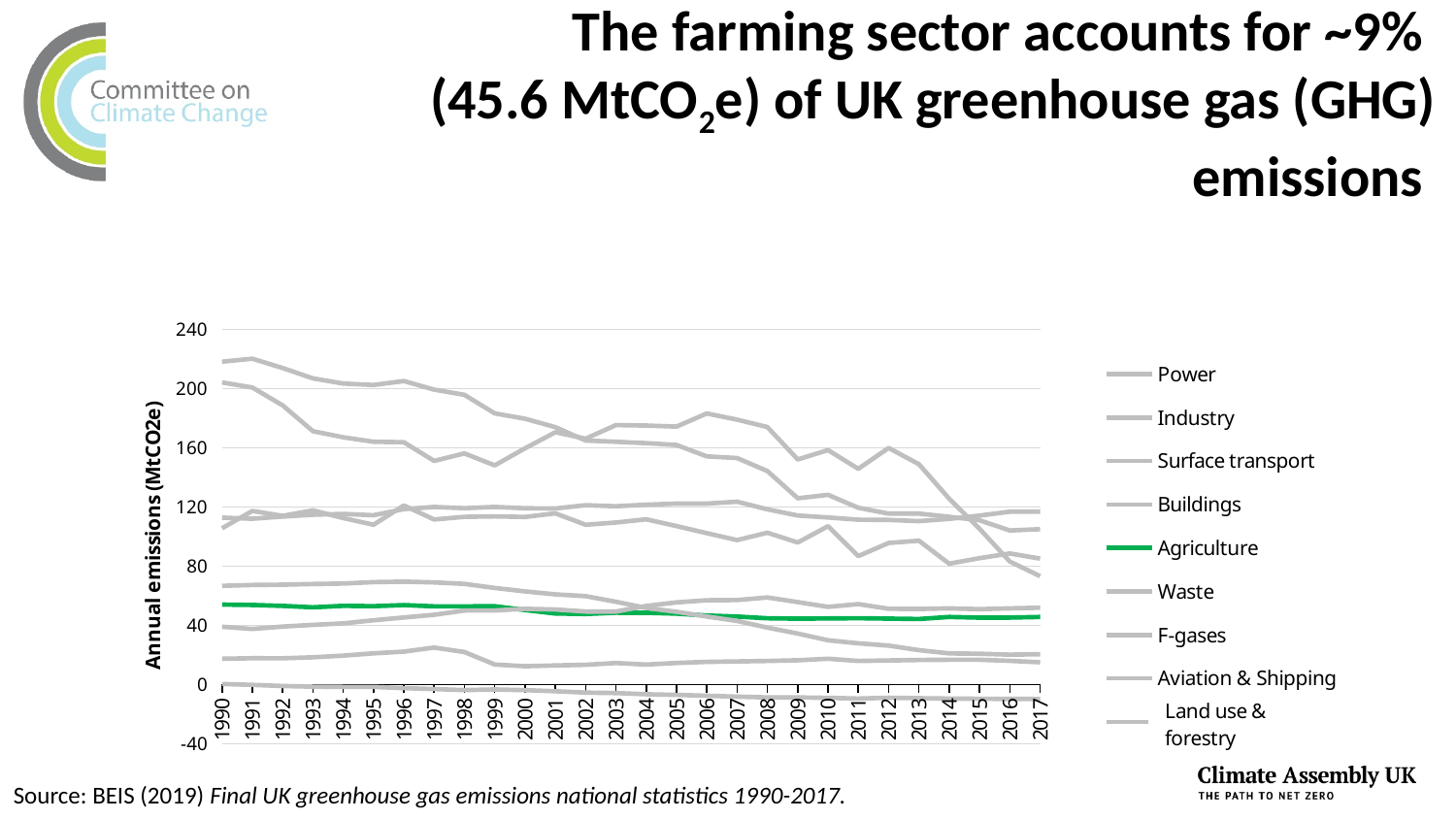
Is the value for Agriculture in 2005 greater or less than 80? less How many series does the legend list? 9 How many years are plotted along the x axis? 28 Does the Agriculture line rise or fall between 1990 and 2017? fall Is the highest plotted value in 2017 greater or less than 160? less Which series is drawn in green? Agriculture What is the first year shown on the x axis? 1990 Is the value for Agriculture in 2017 greater or less than 80? less What is the label on the vertical axis? Annual emissions (MtCO2e) What kind of chart is shown on the slide? line chart